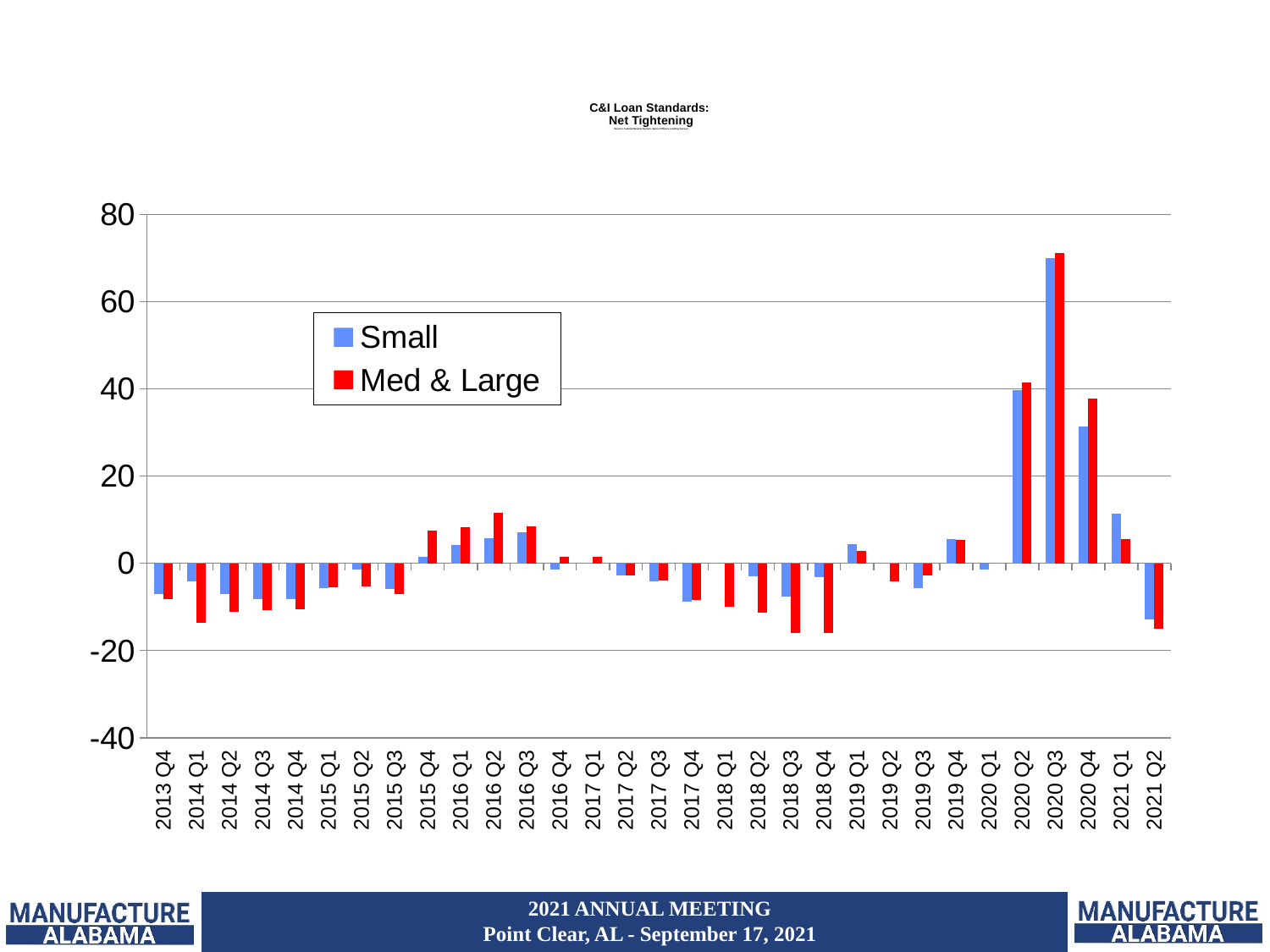
What is the title of the chart? C&I Loan Standards: Net Tightening Is the Small value for 2020 Q2 greater or less than 20? greater In which quarter is the Med & Large value highest? 2020 Q3 In which quarter is the Small value lowest? 2021 Q2 What are the two series named in the legend? Small and Med & Large What kind of chart is shown on the slide? Bar chart How many quarters are shown along the x axis? 31 For 2021 Q1, which series has the larger value, Small or Med & Large? Small How many series does the legend list? 2 For 2020 Q4, which series has the larger value, Small or Med & Large? Med & Large In which quarter is the Small value highest? 2020 Q3 Is the Med & Large value for 2020 Q3 greater or less than 60? greater